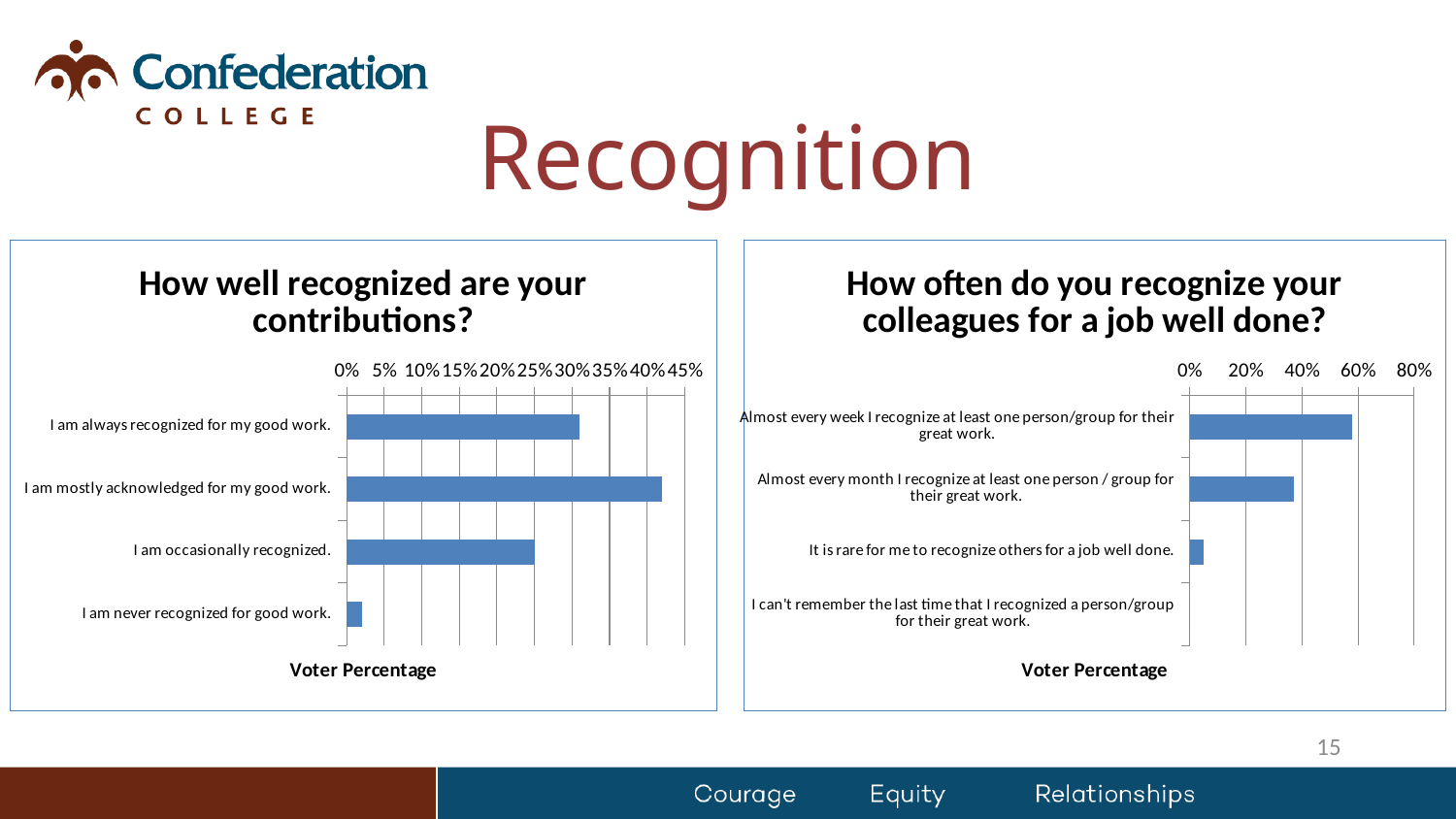
In the chart titled "How often do you recognize your colleagues for a job well done?", is the value for "It is rare for me to recognize others for a job well done." greater or less than 20%? less In the chart titled "How often do you recognize your colleagues for a job well done?", which category has the highest value? Almost every week I recognize at least one person/group for their great work. In the chart titled "How well recognized are your contributions?", is the value for "I am mostly acknowledged for my good work." greater or less than 40%? greater In the chart titled "How well recognized are your contributions?", what kind of chart is shown? bar chart In the chart titled "How well recognized are your contributions?", how many categories are plotted? 4 In the chart titled "How well recognized are your contributions?", is the value for "I am occasionally recognized." greater or less than 30%? less In the chart titled "How well recognized are your contributions?", which category has the lowest value? I am never recognized for good work. In the chart titled "How well recognized are your contributions?", which is larger: the value for "I am always recognized for my good work." or "I am occasionally recognized."? I am always recognized for my good work. In the chart titled "How well recognized are your contributions?", which category has the highest value? I am mostly acknowledged for my good work. In the chart titled "How often do you recognize your colleagues for a job well done?", what is the label on the value axis? Voter Percentage In the chart titled "How often do you recognize your colleagues for a job well done?", how many categories are plotted? 4